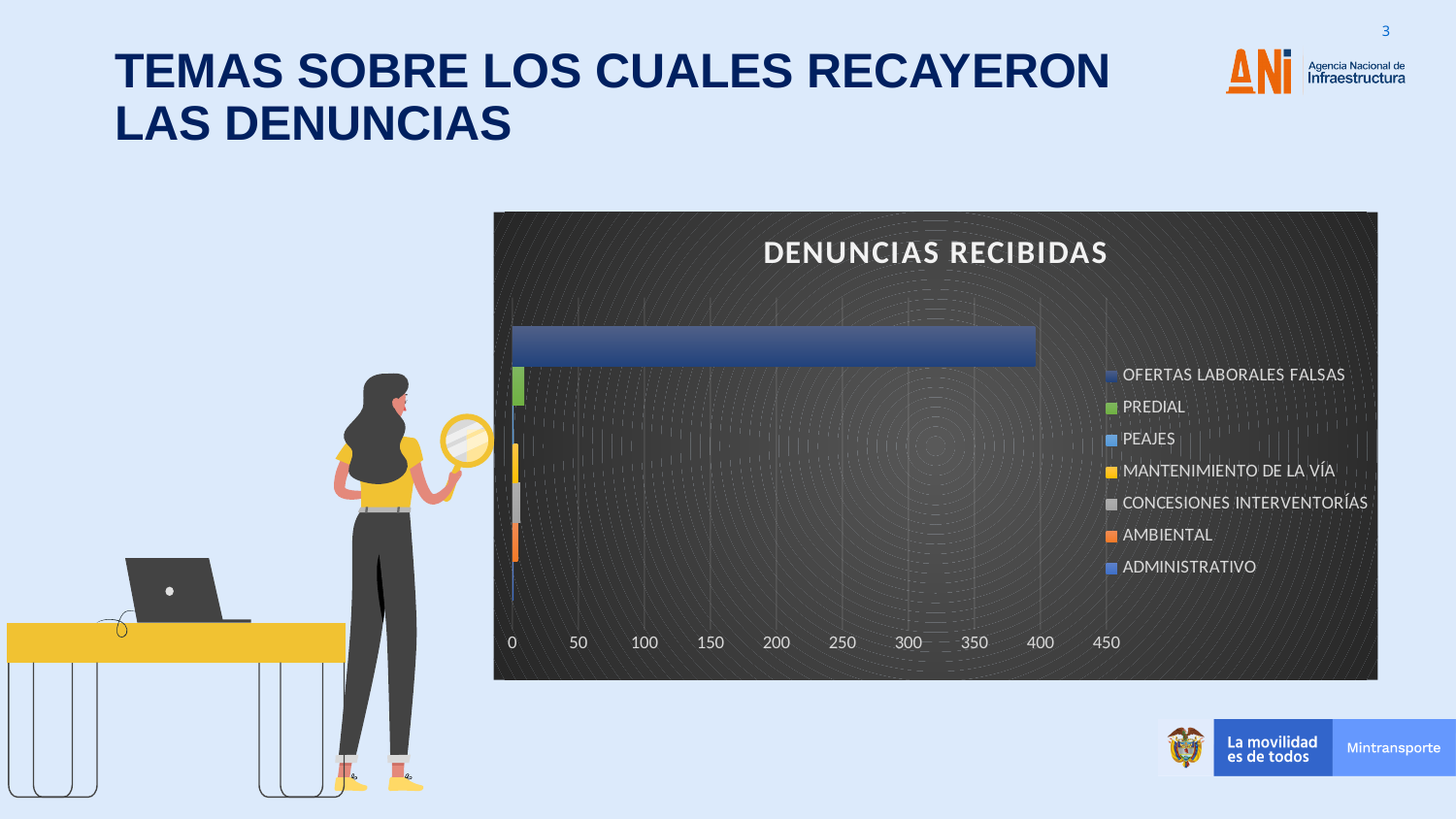
Is the value for AMBIENTAL greater or less than 100? less Is the value for OFERTAS LABORALES FALSAS greater or less than 350? greater What is the highest tick value shown on the horizontal axis? 450 Which legend entry is shown in green? PREDIAL Which is larger, the value for OFERTAS LABORALES FALSAS or the value for CONCESIONES INTERVENTORÍAS? OFERTAS LABORALES FALSAS What is the title of the chart? DENUNCIAS RECIBIDAS Is the value for PREDIAL greater or less than 50? less How many entries does the chart's legend list? 7 Which category has the highest value in the chart? OFERTAS LABORALES FALSAS What type of chart is shown on the slide? bar chart